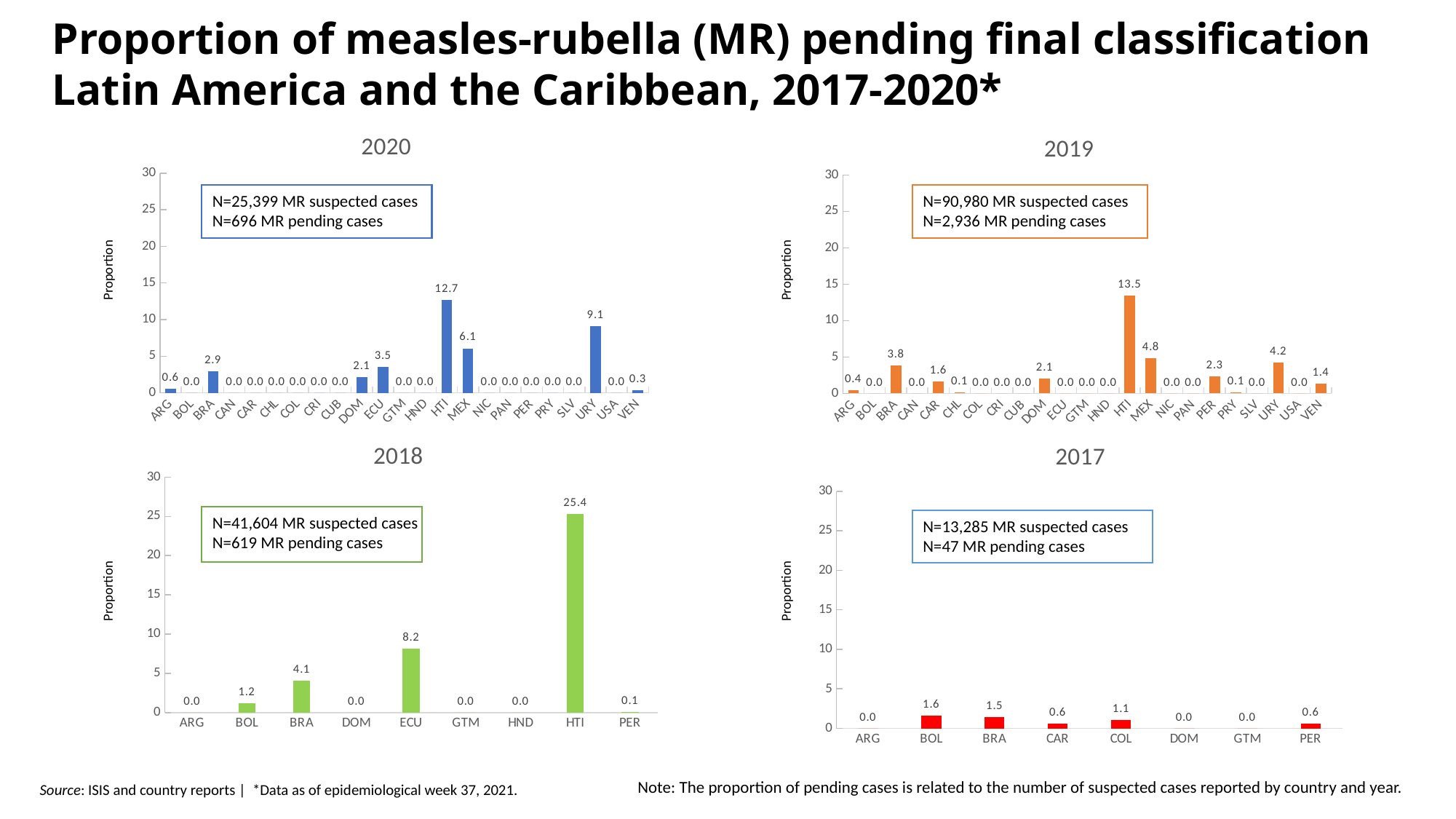
How many countries are shown on the x axis of the 2017 chart? 8 According to the text box in the 2019 chart, how many MR pending cases were there? 2,936 In the 2018 chart, what is the difference between the proportions for ECU and BRA? 4.1 In the 2017 chart, which country has the highest proportion? BOL In the 2019 chart, what is the proportion for MEX? 4.8 In the 2018 chart, is the value for HTI greater or less than 20? greater What type of chart is the 2019 chart? Bar chart In the 2020 chart, what is the difference between the proportions for HTI and URY? 3.6 In the 2018 chart, which country has the highest proportion? HTI In the 2020 chart, what is the proportion for HTI? 12.7 In the 2019 chart, which is larger, the proportion for BRA or the proportion for URY? URY How many countries are shown on the x axis of the 2018 chart? 9